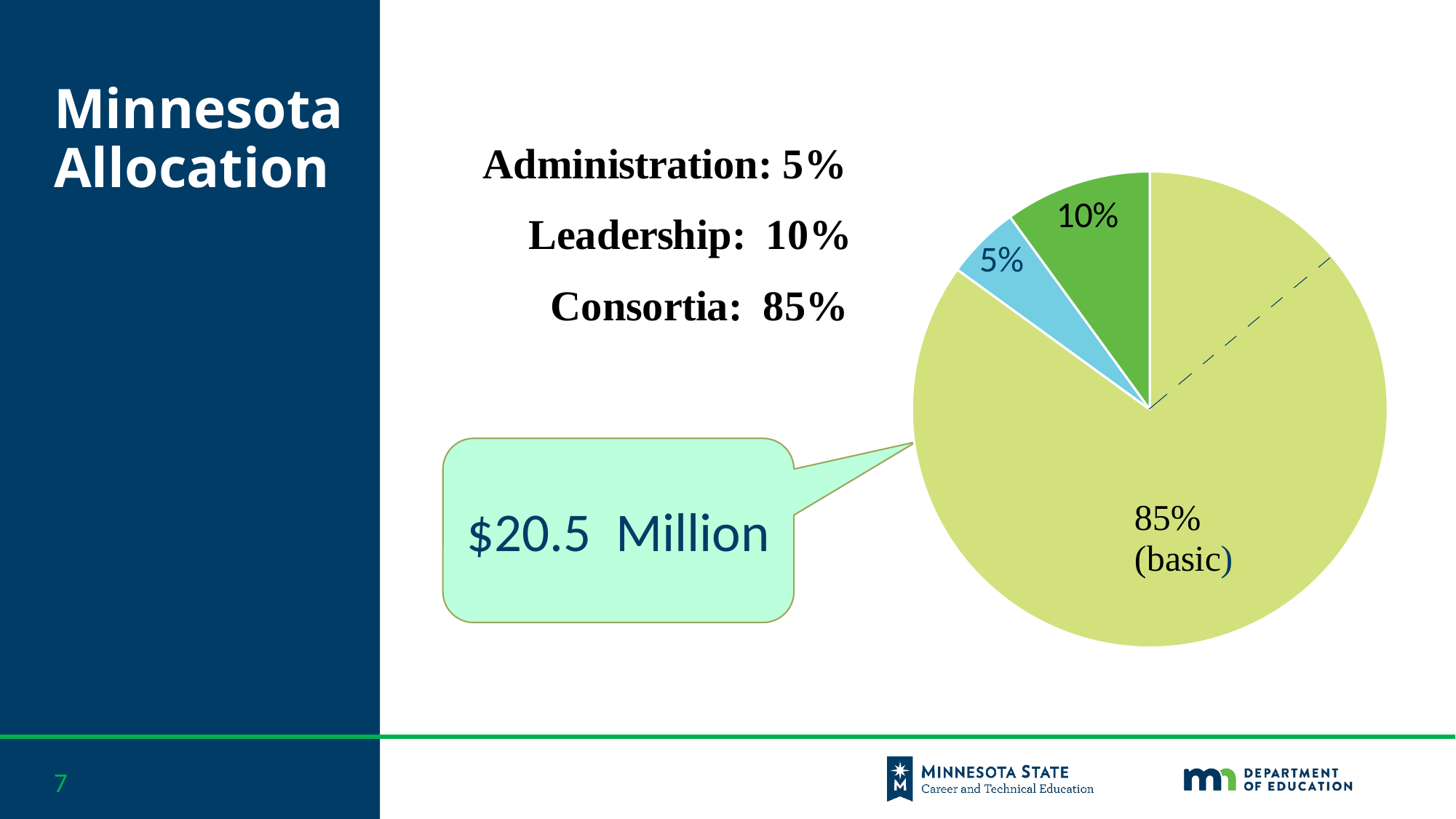
What kind of chart is shown on the slide? pie chart Which category receives the smallest share of the allocation? Administration What percentage of the allocation goes to Consortia? 85% What percentage of the allocation goes to Leadership? 10% What total dollar amount does the callout attached to the pie chart show? $20.5 Million What percentage of the allocation goes to Administration? 5% What is the difference in percentage points between the Leadership and Administration shares? 5% Which is larger, the Leadership share or the Administration share? Leadership What colour is the 5% slice of the pie chart? light blue What share of the pie is labelled as basic? 85% Which category receives the largest share of the allocation? Consortia How many slices does the pie chart have? 3